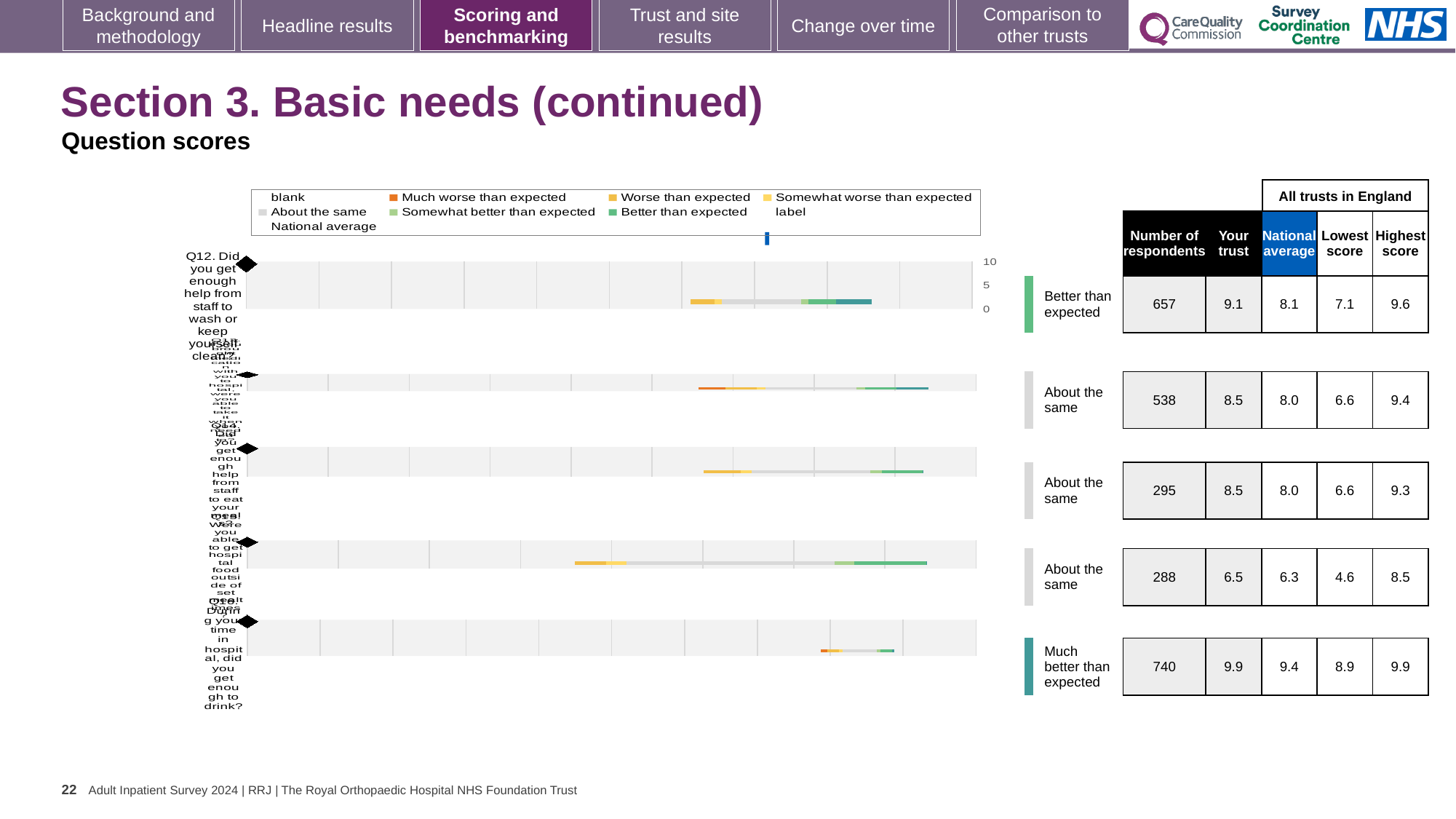
What is the national average score for the last row, Q16 (did you get enough to drink)? 9.4 How many question rows (bars) are plotted in the chart? 5 For Q12, how much higher is the 'Your trust' score than the national average? 1.0 Which question row has the lowest 'Your trust' score? Q15 (fourth row), 6.5 What kind of chart is shown on the slide? bar chart How many respondents are listed for the fourth row, Q15 (hospital food outside of set meal times)? 288 What benchmark category is shown for Q16 (did you get enough to drink)? Much better than expected Which is larger: the 'Your trust' score for Q12 or for Q16? Q16 What is the 'Your trust' score for Q12 (help from staff to wash or keep yourself clean)? 9.1 What is the highest score across all trusts in England for the third row, Q14 (help from staff to eat your meal)? 9.3 Which question row has the highest 'Your trust' score? Q16 (fifth row), 9.9 What benchmark category is shown for Q12 (help to wash or keep yourself clean)? Better than expected